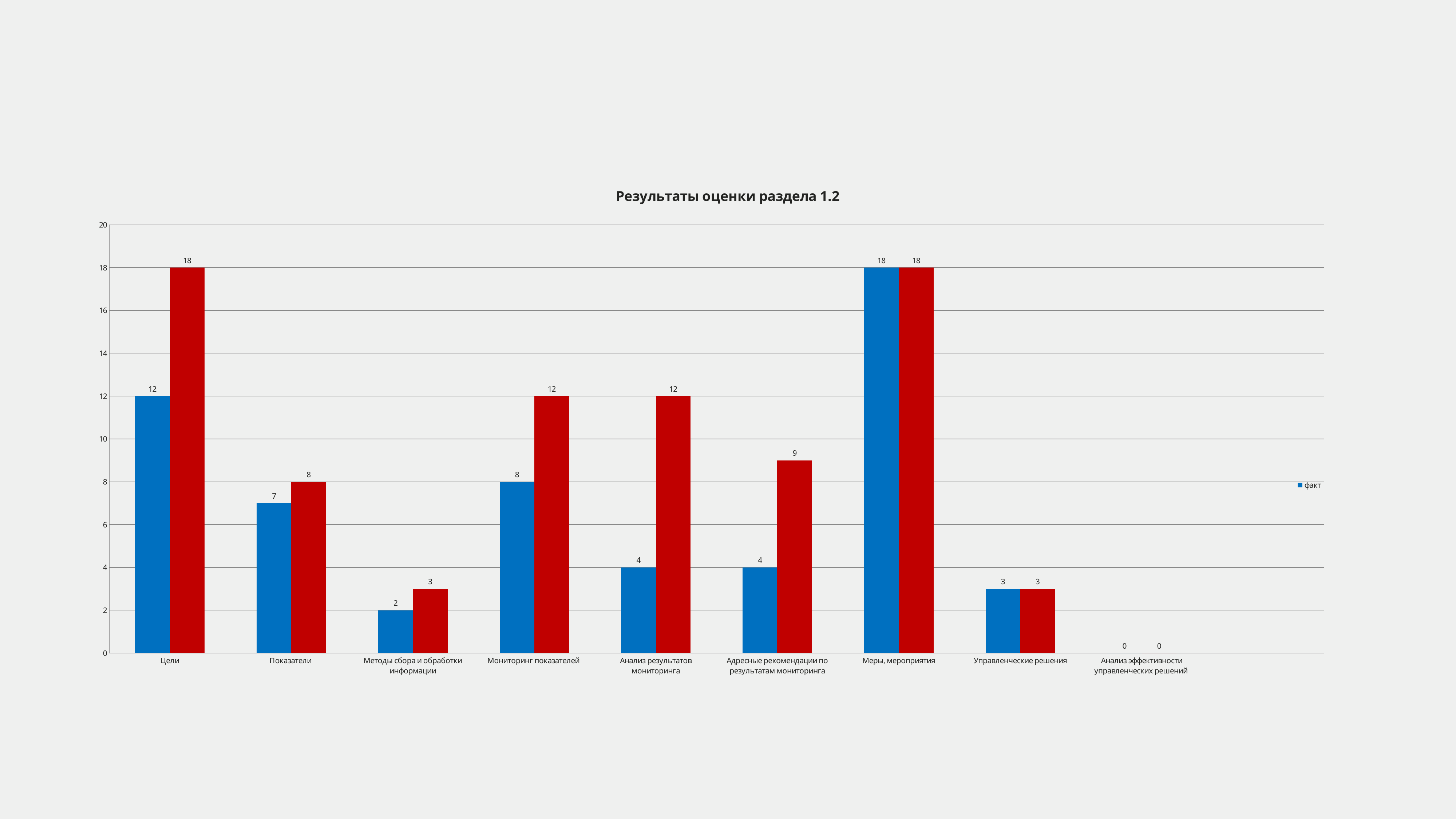
What is the difference between the red bar and the факт (blue) bar for Цели? 6 What kind of chart is shown on the slide? bar chart Which is larger for Мониторинг показателей: the факт (blue) bar or the red bar? the red bar Which category has the highest факт (blue) value? Меры, мероприятия What is the value of the red bar for Адресные рекомендации по результатам мониторинга? 9 How many categories are shown on the x axis of the chart? 9 What is the value of the факт (blue) bar for Цели? 12 What is the difference between the red bar and the факт (blue) bar for Анализ результатов мониторинга? 8 What is the value of the факт (blue) bar for Показатели? 7 Which series name is listed in the chart legend? факт What is the title of the chart? Результаты оценки раздела 1.2 Which category has the lowest red bar value? Анализ эффективности управленческих решений